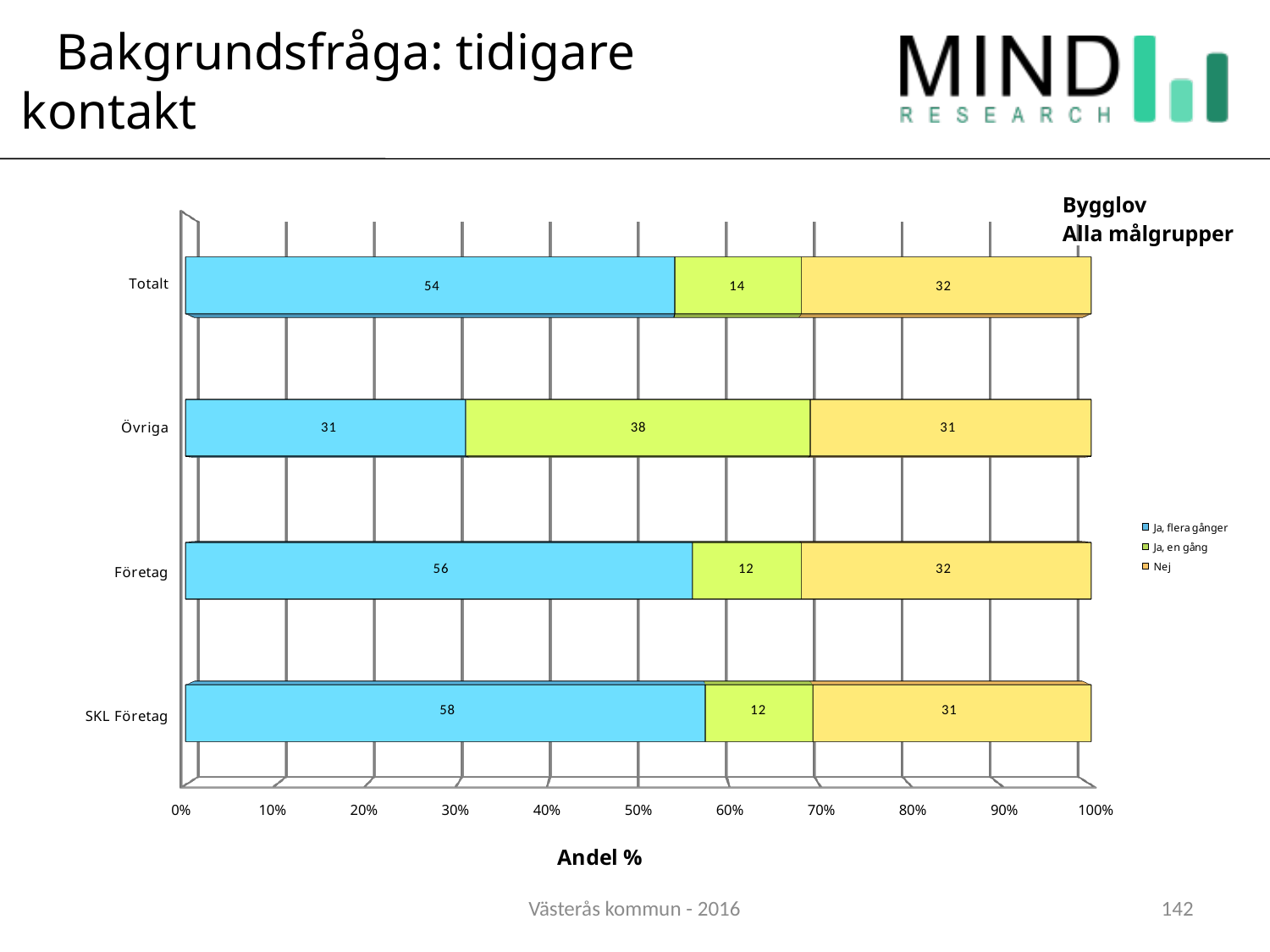
Which category has the lowest value for "Ja, flera gånger"? Övriga What is the value for "Ja, flera gånger" in the Totalt category? 54 What is the value for "Nej" in the Företag category? 32 What is the value for "Ja, en gång" in the Övriga category? 38 Which is larger: the "Ja, flera gånger" value for Företag or for Totalt? Företag Which category has the highest value for "Ja, flera gånger"? SKL Företag How many categories are shown on the y axis? 4 What is the total of the stacked bar for Övriga? 100 What is the label of the x axis? Andel % What is the difference between the "Ja, en gång" values for Övriga and Företag? 26 How many series does the legend list? 3 What kind of chart is shown on the slide? Stacked bar chart